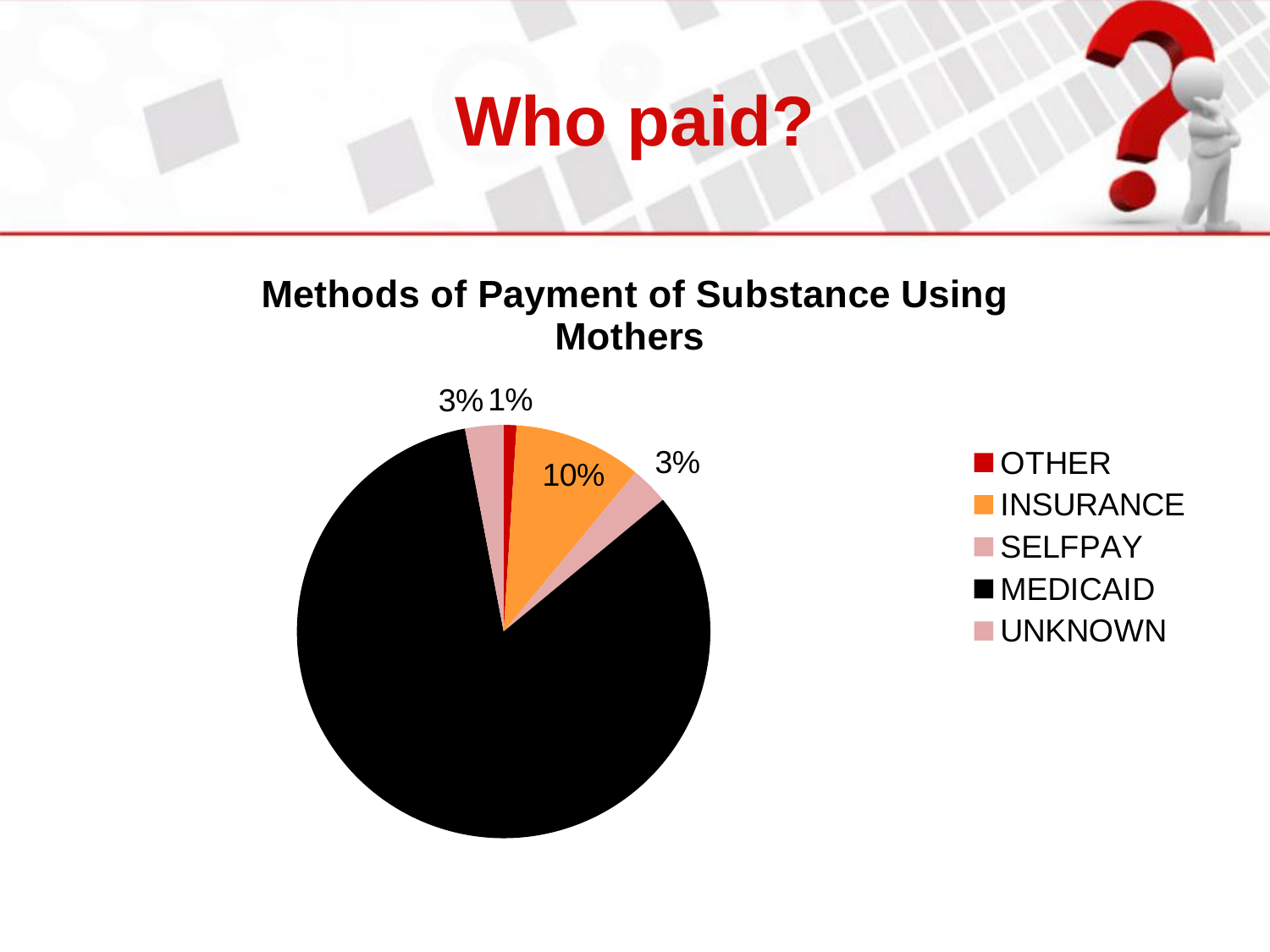
What is the value shown for SELFPAY? 3% What is the difference between the INSURANCE share and the SELFPAY share? 7% What colour represents MEDICAID in the pie chart? black Which payment method has the smallest slice of the pie? OTHER What type of chart is shown on the slide? pie chart Which payment method has the largest slice of the pie? MEDICAID How many entries does the legend list? 5 What is the value shown for OTHER? 1% What share of the pie does INSURANCE account for? 10% Which is larger, the INSURANCE slice or the OTHER slice? INSURANCE How many payment categories are shown in the pie chart? 5 What is the title of the chart? Methods of Payment of Substance Using Mothers